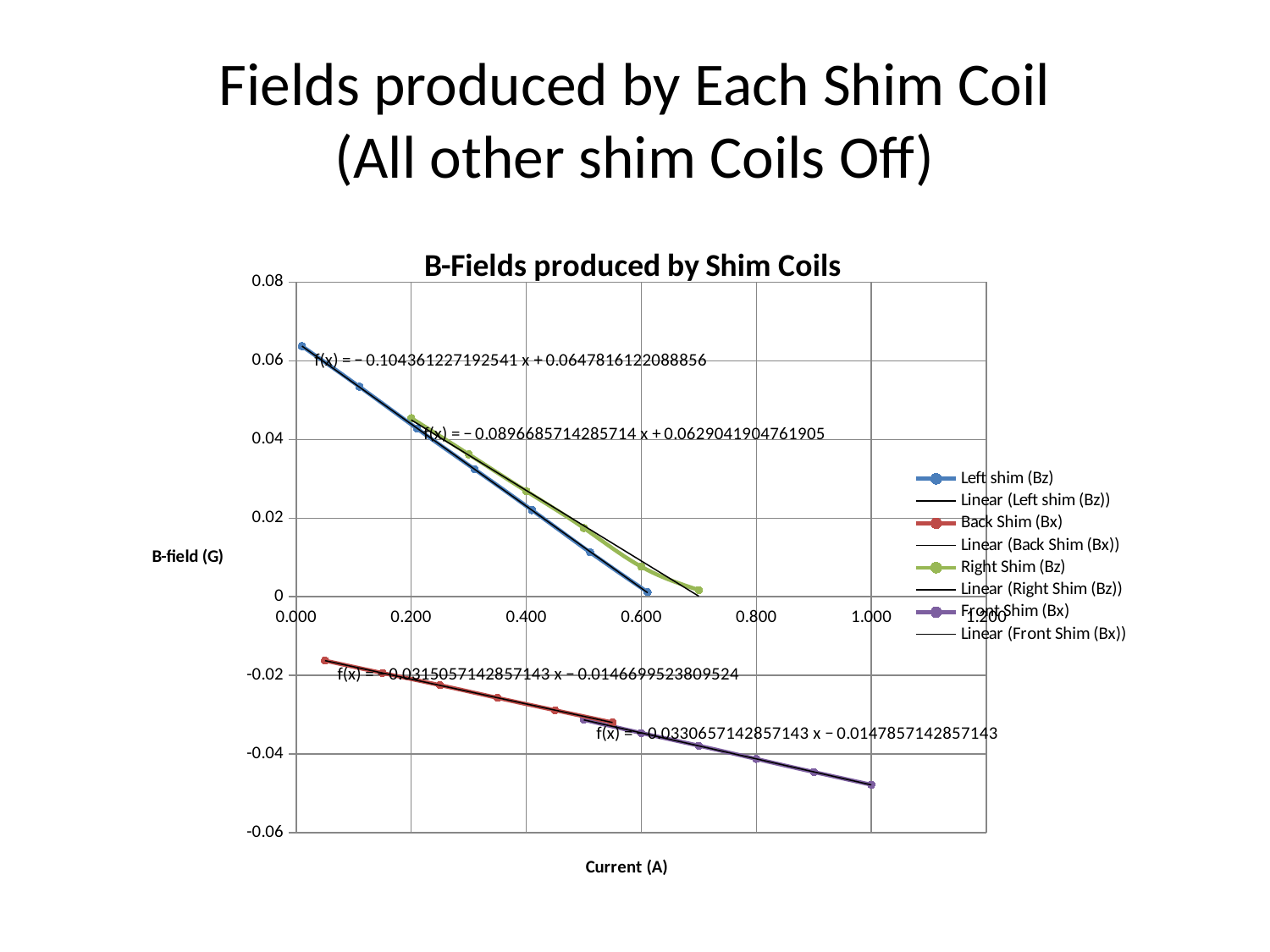
Does the B-field for Left shim (Bz) rise or fall as the current increases? fall How many data series (excluding the linear trendlines) are plotted on the chart? 4 Does the B-field for Front Shim (Bx) rise or fall as the current increases? fall What is the label of the x axis of the chart? Current (A) Is the B-field value for Left shim (Bz) at a current of 0.000 A greater or less than 0.06? greater How many entries does the legend of the chart list? 8 What is the title of the chart? B-Fields produced by Shim Coils Which series reaches the lowest B-field value on the chart? Front Shim (Bx) What kind of chart is shown on the slide? line chart Is the B-field value for Front Shim (Bx) at a current of 1.000 A greater or less than -0.04? less Which series reaches the highest B-field value on the chart? Left shim (Bz) Which series has the larger B-field value at a current of 0.200 A, Left shim (Bz) or Back Shim (Bx)? Left shim (Bz)